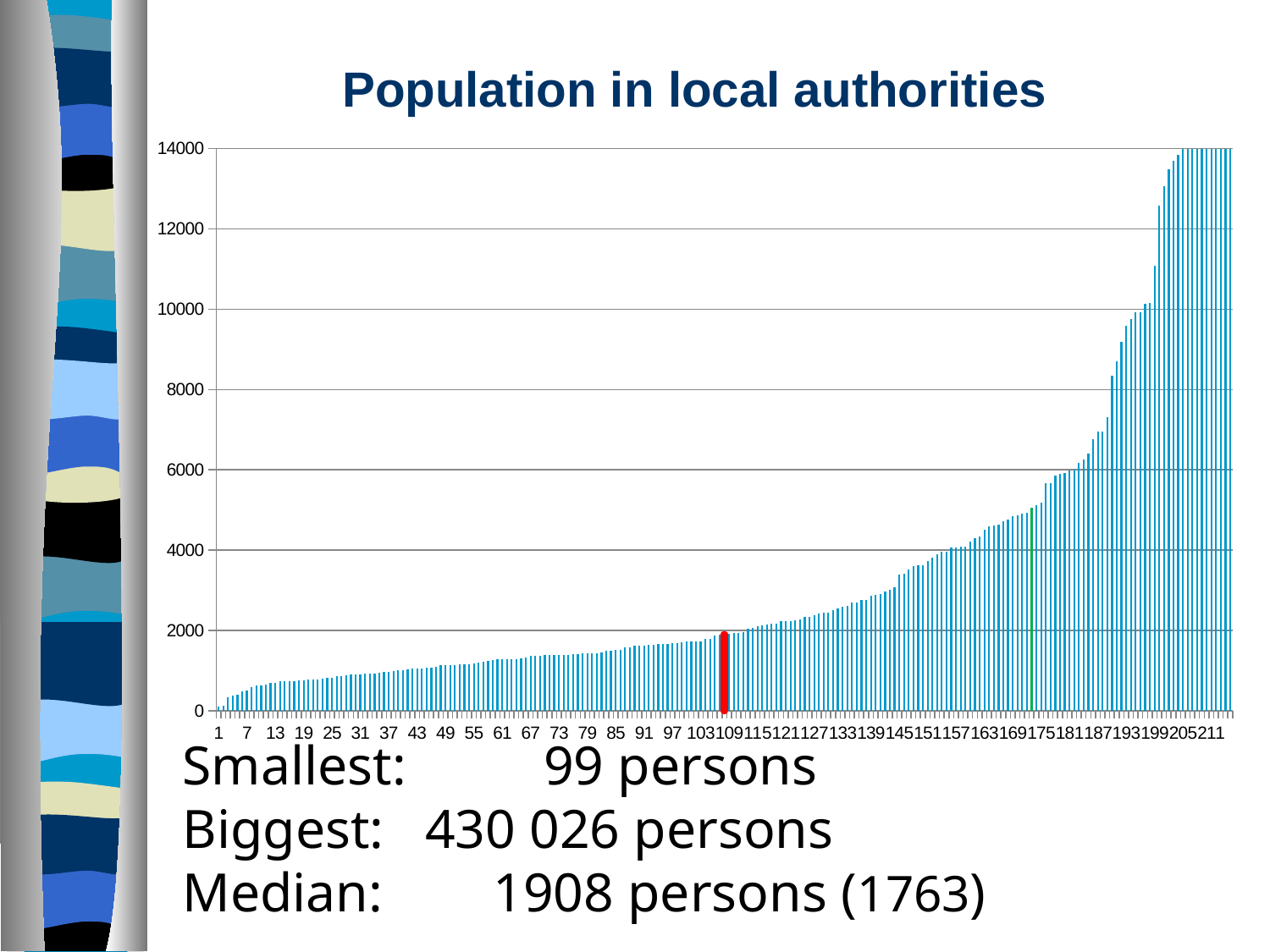
Is the value for category 187 greater or less than 8000? less Is the value for category 1 greater or less than 2000? less Do the bar values rise or fall from left to right along the x axis? rise Is the value for category 61 greater or less than 2000? less What kind of chart is shown on the slide? bar chart Which category has the lowest value? 1 Which has the larger value, category 7 or category 205? 205 What is the highest value shown on the y axis? 14000 What is the title of the chart? Population in local authorities